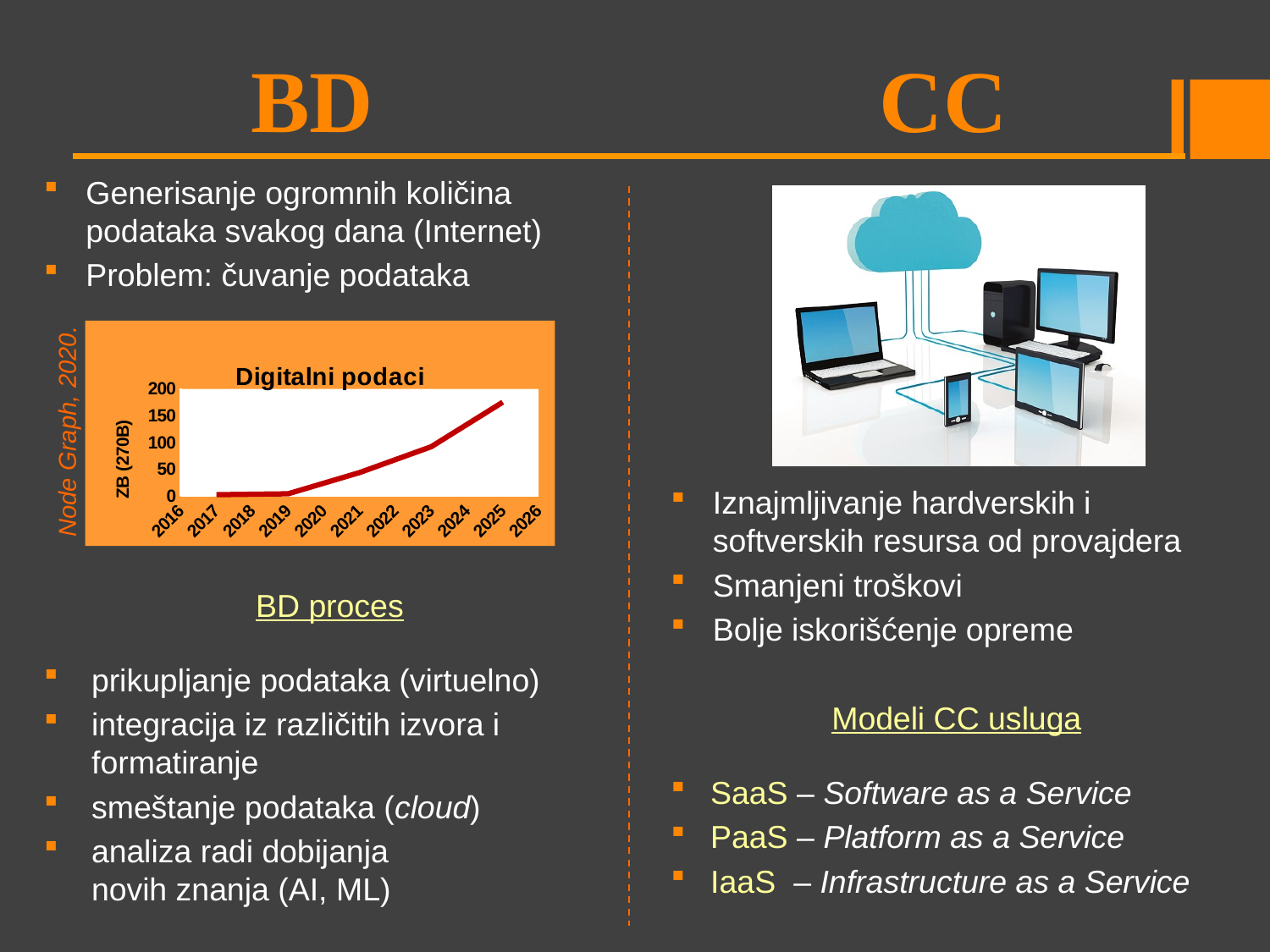
How many year labels are shown on the x axis of the "Digitalni podaci" chart? 11 What is the label of the vertical axis of the "Digitalni podaci" chart? ZB (270B) Do the values in the "Digitalni podaci" chart rise or fall from 2017 to 2025? rise What kind of chart is the "Digitalni podaci" chart? line chart Is the value for 2025 in the "Digitalni podaci" chart greater or less than 150? greater What is the title of the chart on the slide? Digitalni podaci Which year has the highest value in the "Digitalni podaci" chart? 2025